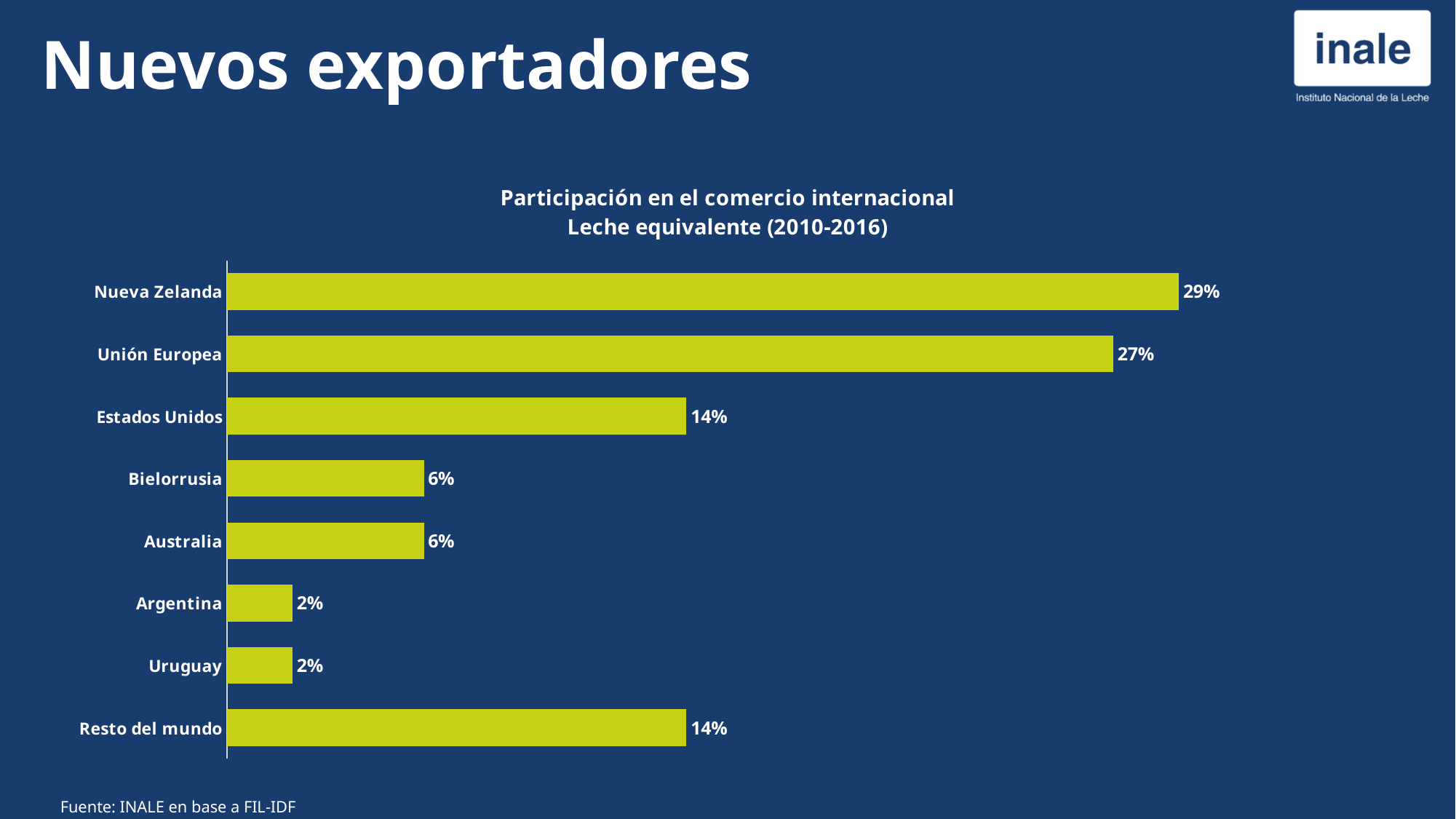
What colour are the bars in the chart? Yellow-green What is the value for Nueva Zelanda? 29% What is the difference between the values for Nueva Zelanda and Unión Europea? 2% What is the value for Estados Unidos? 14% What is the value for Uruguay? 2% How many categories are shown in the chart? 8 What kind of chart is shown on the slide? Bar chart Which category has the highest value? Nueva Zelanda Which is larger, the value for Unión Europea or the value for Estados Unidos? Unión Europea Which is larger, the value for Australia or the value for Argentina? Australia What is the title of the chart? Participación en el comercio internacional Leche equivalente (2010-2016) What is the difference between the values for Estados Unidos and Bielorrusia? 8%